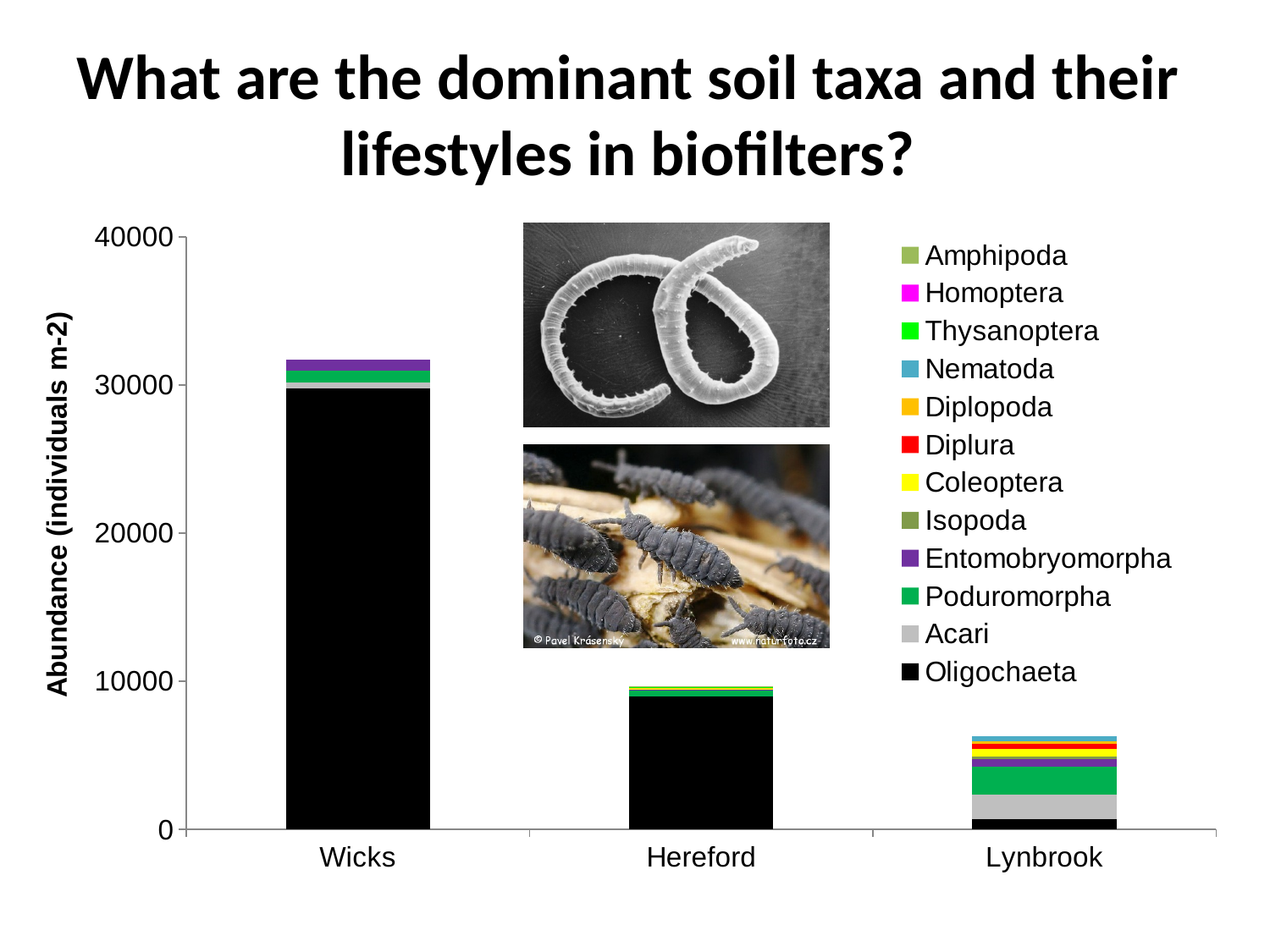
Which has a larger total abundance, Hereford or Lynbrook? Hereford What is the label of the y axis? Abundance (individuals m-2) How many categories are shown on the x axis of the chart? 3 Do the total bar heights rise or fall from Wicks to Lynbrook along the x axis? Fall How many series does the chart's legend list? 12 Which site has the lowest total abundance? Lynbrook Which series is shown in black in the legend? Oligochaeta Which site has the highest total abundance? Wicks What kind of chart is shown on the slide? Stacked bar chart Is the total abundance for Hereford greater or less than 10000? less Is the total abundance for Lynbrook greater or less than 10000? less Is the total abundance for Wicks greater or less than 30000? greater